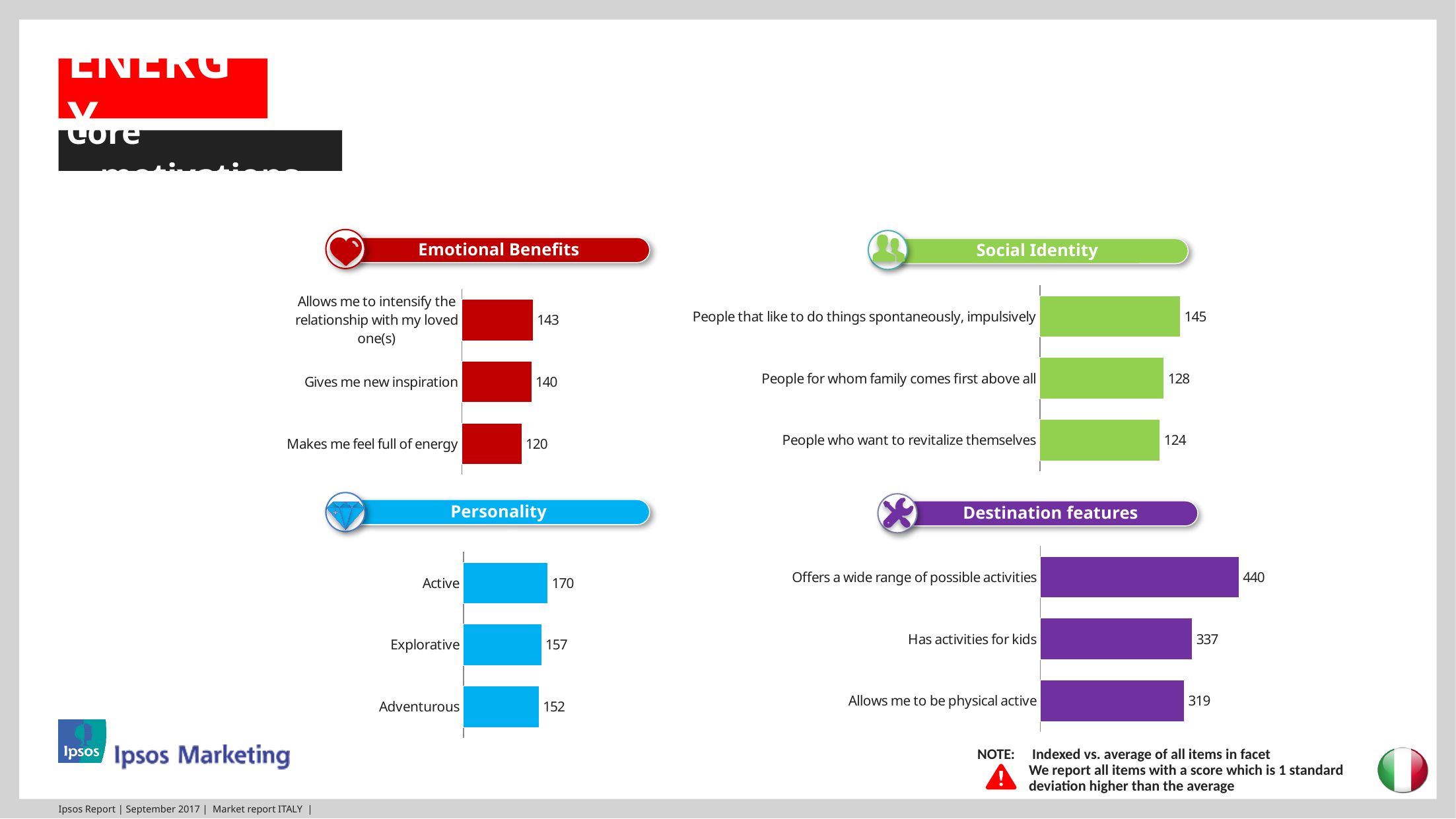
In the Emotional Benefits chart, what is the value for "Gives me new inspiration"? 140 In the Social Identity chart, which category has the highest value? People that like to do things spontaneously, impulsively In the Destination features chart, which category has the highest value? Offers a wide range of possible activities In the Social Identity chart, what is the difference between the highest and lowest values? 21 What type of chart is the Emotional Benefits chart? Bar chart In the Emotional Benefits chart, which category has the lowest value? Makes me feel full of energy In the Destination features chart, what is the difference between "Offers a wide range of possible activities" and "Allows me to be physical active"? 121 How many categories are shown in the Personality chart? 3 In the Social Identity chart, what is the value for "People for whom family comes first above all"? 128 In the Personality chart, what is the value for "Explorative"? 157 In the Personality chart, which is larger, Active or Adventurous? Active In the Destination features chart, what is the value for "Has activities for kids"? 337